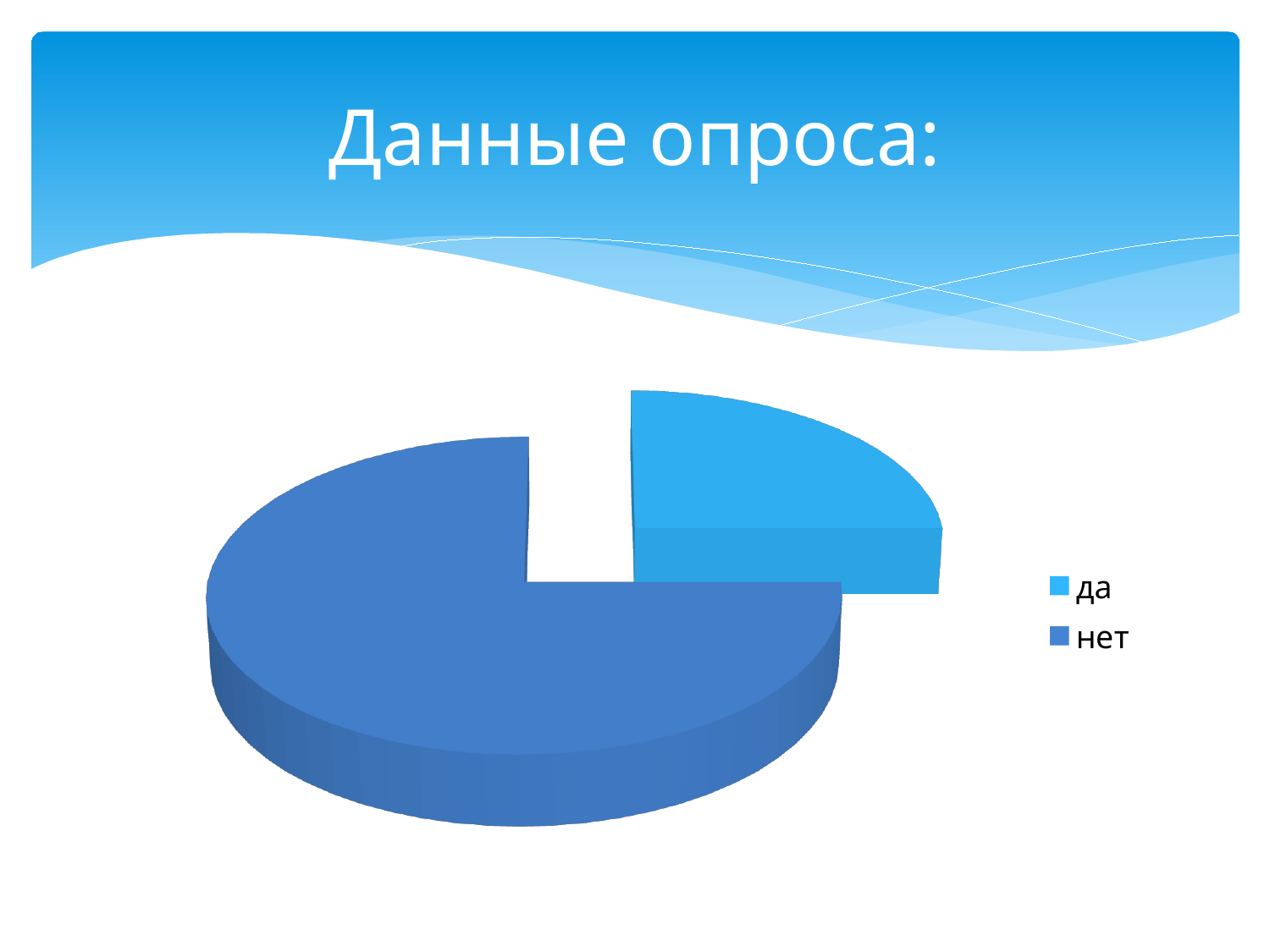
How many entries does the legend list? 2 What is the title of the slide containing the chart? Данные опроса: Which category has the smallest slice of the pie? да Which category has the largest slice of the pie? нет Which slice is larger, "да" or "нет"? нет How many slices does the pie chart have? 2 Which legend entry is shown in the lighter blue colour? да What kind of chart is shown on the slide? pie chart